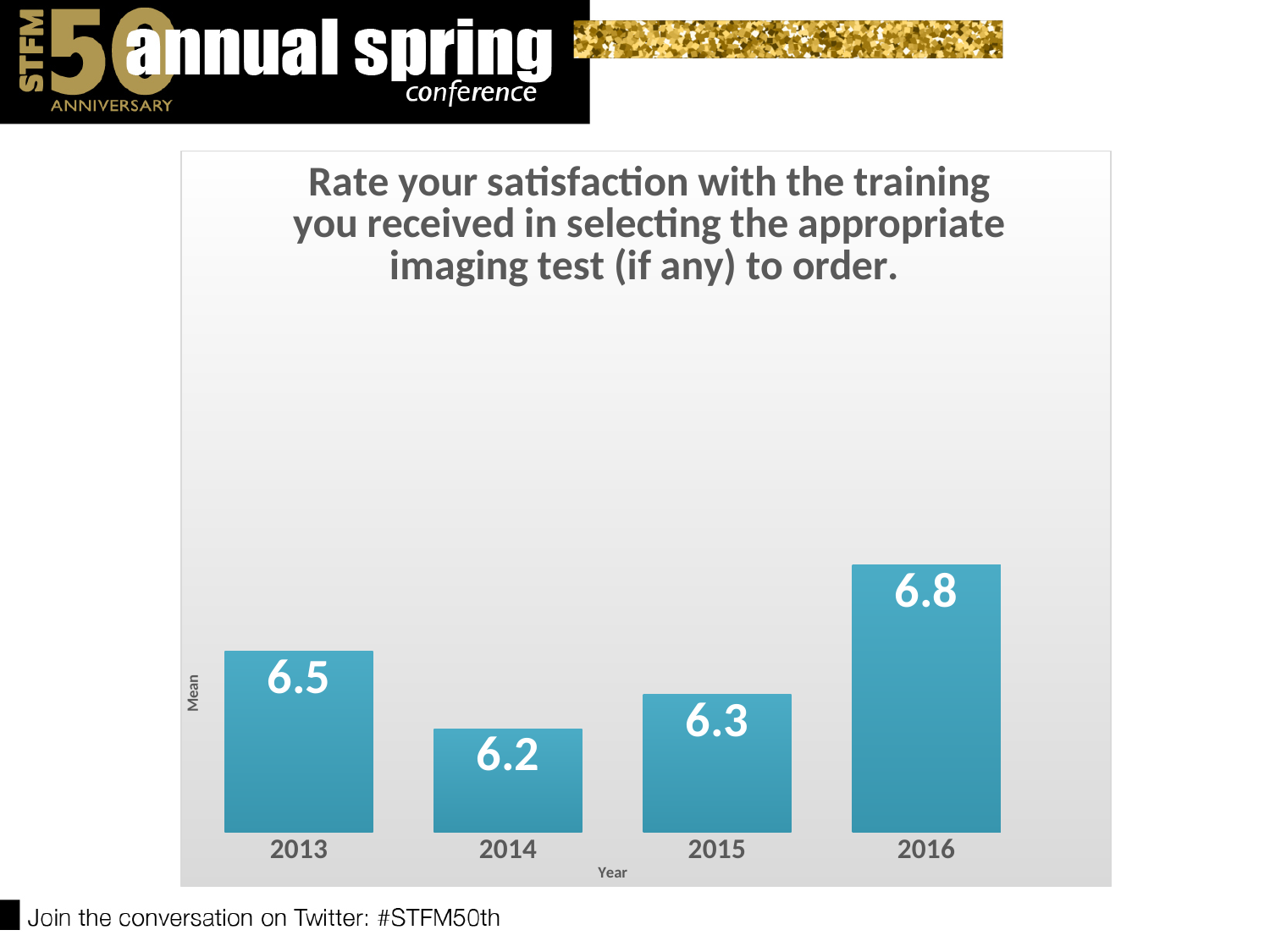
What is the mean satisfaction value for 2016? 6.8 What is the mean satisfaction value for 2014? 6.2 What is the label of the x axis? Year How many years are shown on the x axis? 4 What kind of chart is shown on the slide? Bar chart What is the mean satisfaction value for 2013? 6.5 Which year has the highest mean satisfaction value? 2016 What is the difference between the mean values for 2016 and 2014? 0.6 Which year has the lowest mean satisfaction value? 2014 What is the mean satisfaction value for 2015? 6.3 Do the mean values rise or fall from 2014 to 2016? Rise Which year has a larger mean value, 2013 or 2015? 2013